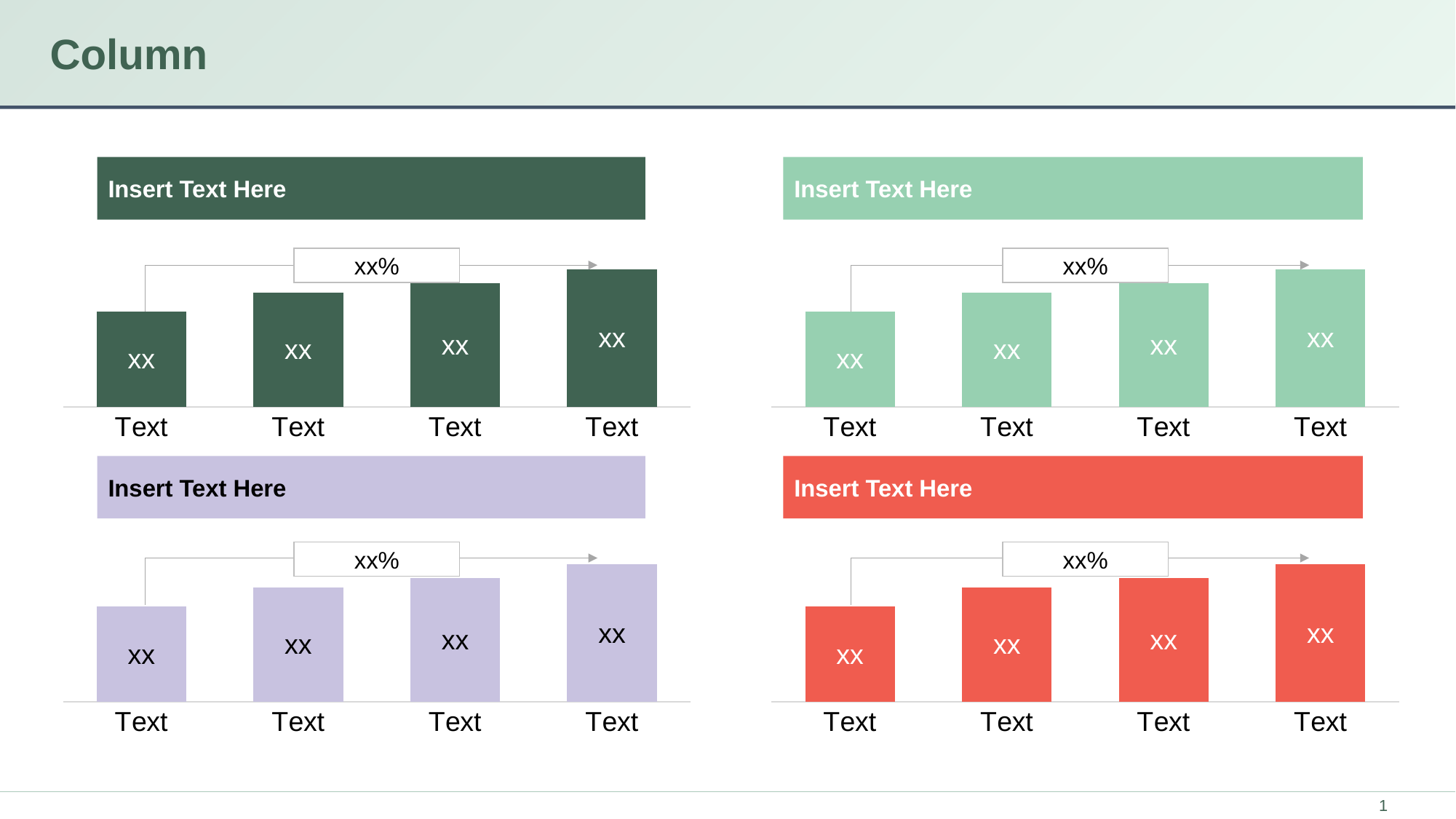
How many bars does the top-left chart have? 4 What kind of chart is the top-left chart? bar chart In the bottom-left chart, which bar is the shortest: the leftmost or the rightmost? leftmost In the top-right chart, is the leftmost bar or the rightmost bar taller? rightmost What is the title of the slide? Column In the top-left chart, do the bar heights rise or fall from left to right? rise In the bottom-right chart, do the bar heights rise or fall from left to right? rise How many bars does the bottom-right chart have? 4 In the bottom-left chart, which bar is the tallest: the leftmost or the rightmost? rightmost How many bar charts are shown on the slide? 4 What colour are the bars in the bottom-right chart? red